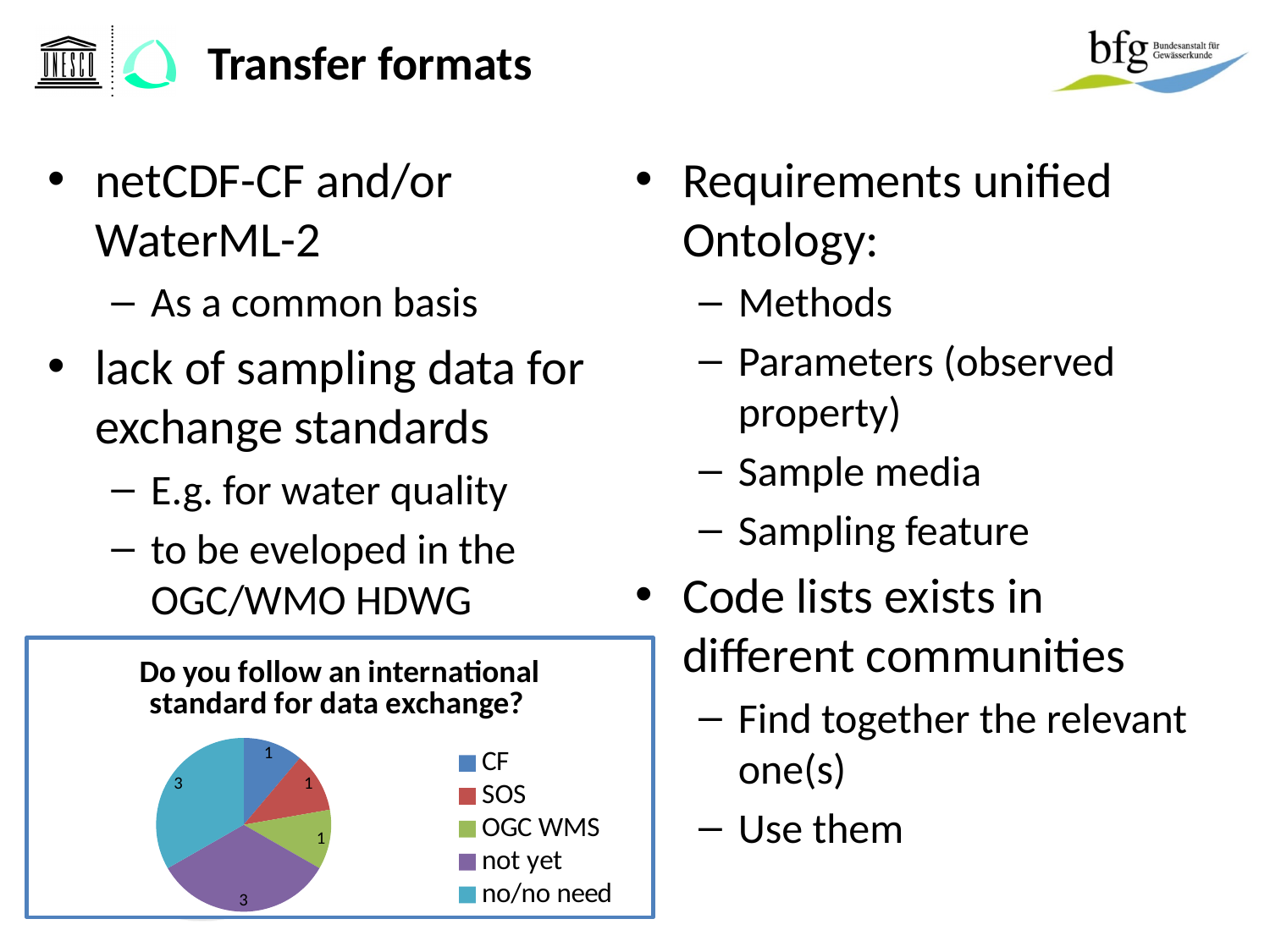
Which is larger in the pie chart, 'not yet' or 'SOS'? not yet What is the value for 'not yet' in the pie chart? 3 How many categories does the pie chart have? 5 What type of chart is shown on the slide? pie chart What is the value for 'OGC WMS' in the pie chart? 1 How many entries does the legend of the pie chart list? 5 What is the value for 'CF' in the pie chart? 1 What is the total of all the values shown in the pie chart? 9 What is the title of the pie chart? Do you follow an international standard for data exchange? What is the value for 'no/no need' in the pie chart? 3 What is the difference between the values for 'no/no need' and 'CF' in the pie chart? 2 Which colour represents 'CF' in the pie chart? blue